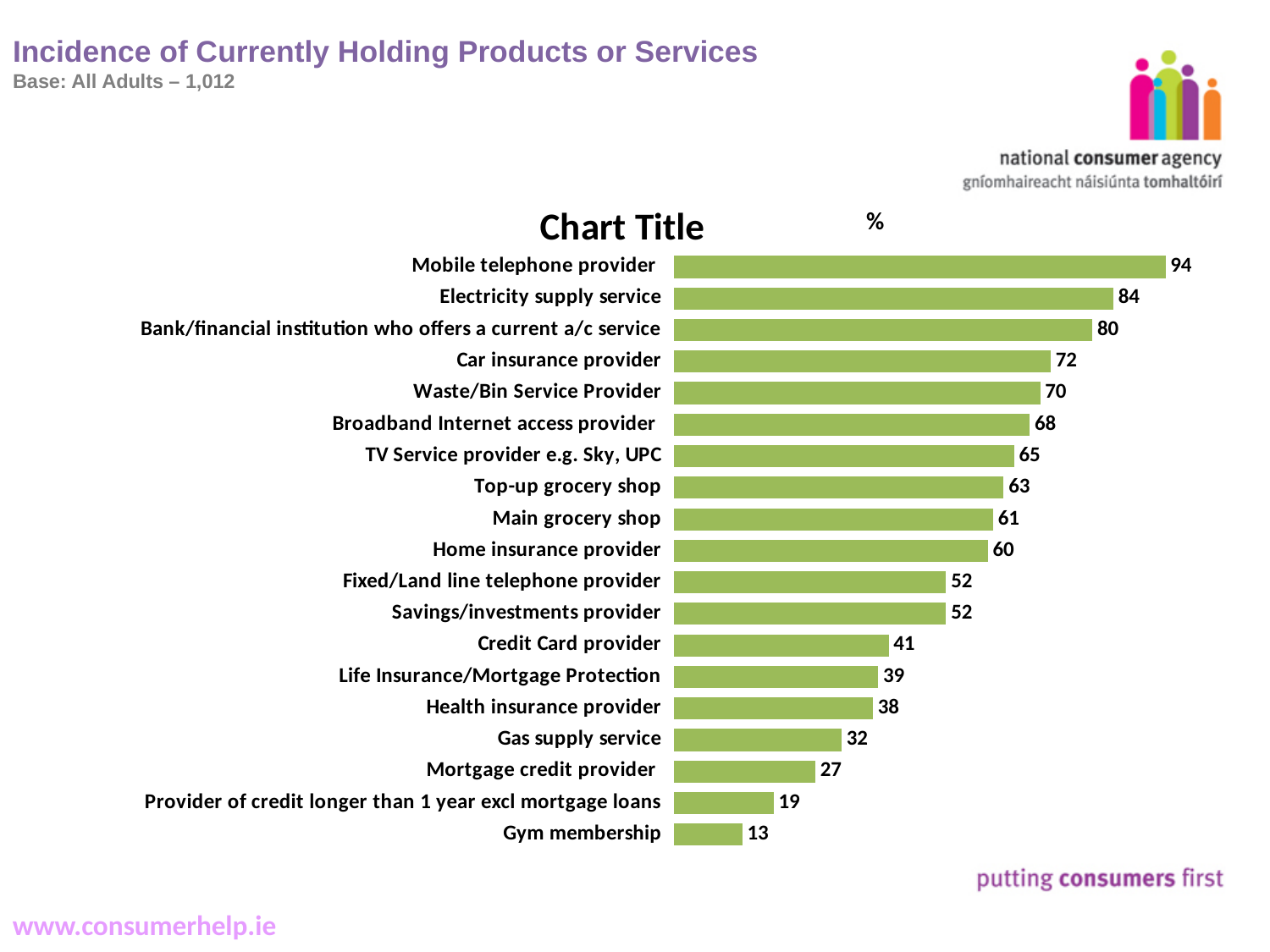
What is the value for Mobile telephone provider? 94 What is the value for Provider of credit longer than 1 year excl mortgage loans? 19 What is the value for Gas supply service? 32 What kind of chart is shown on the slide? Bar chart How many categories are shown in the chart? 19 Which category has the lowest value? Gym membership What is the difference between the values for Broadband Internet access provider and Gym membership? 55 Which is larger, the value for Credit Card provider or the value for Mortgage credit provider? Credit Card provider What colour are the bars in the chart? Green Which category has the highest value? Mobile telephone provider What is the difference between the values for Electricity supply service and Car insurance provider? 12 What is the value for Health insurance provider? 38